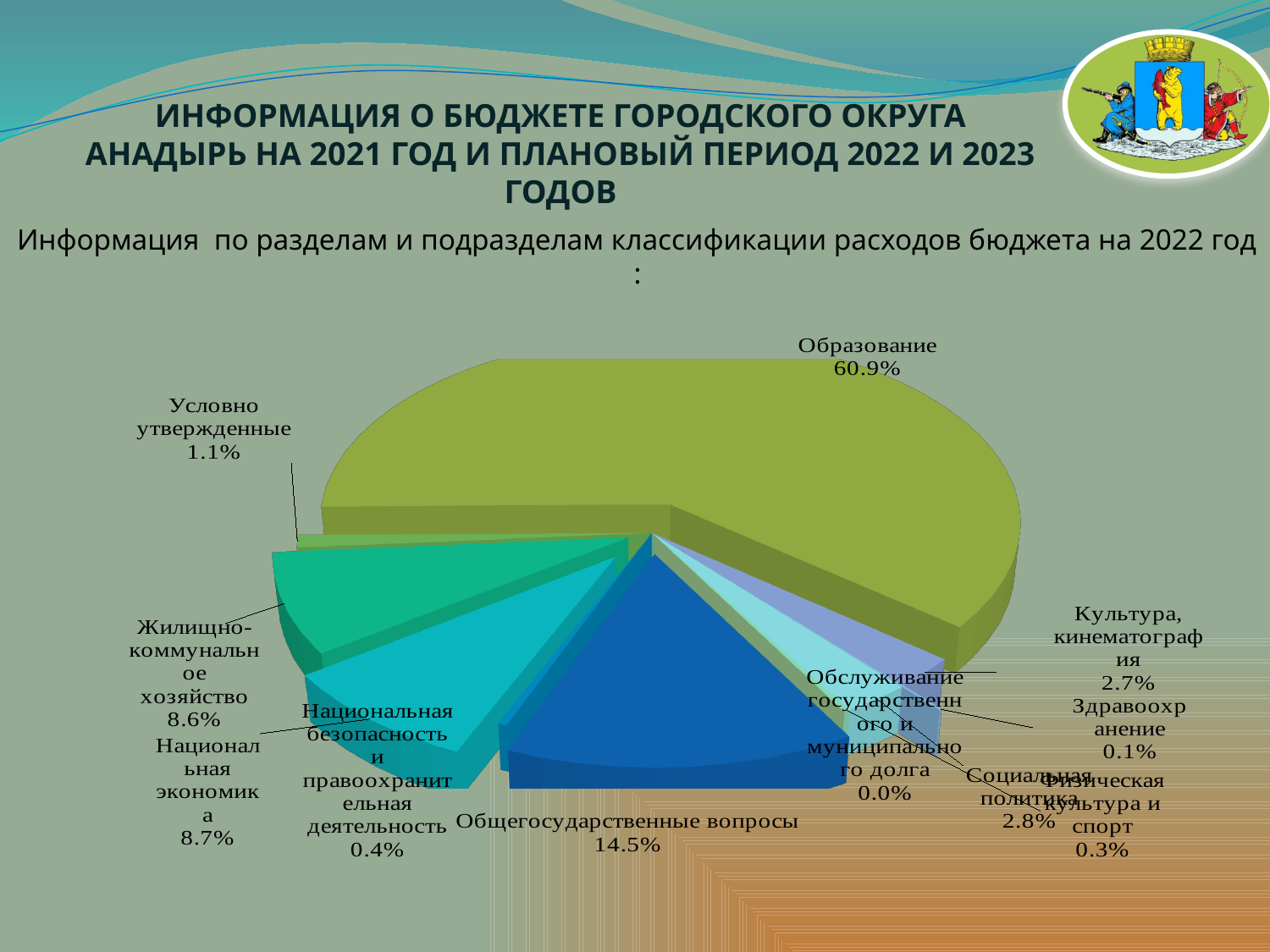
Which category has the smallest share of the pie? Обслуживание государственного и муниципального долга What share of the pie does Образование have? 60.9% What is the value shown for Общегосударственные вопросы? 14.5% Which category has the largest share of the pie? Образование What kind of chart is shown on the slide? pie chart Which is larger, the share for Национальная экономика or the share for Жилищно-коммунальное хозяйство? Национальная экономика What is the value shown for Жилищно-коммунальное хозяйство? 8.6% What is the value shown for Здравоохранение? 0.1% What is the value shown for Социальная политика? 2.8% What is the value shown for Условно утвержденные? 1.1% How many categories are shown in the pie chart? 11 What is the difference between the shares of Образование and Общегосударственные вопросы? 46.4%